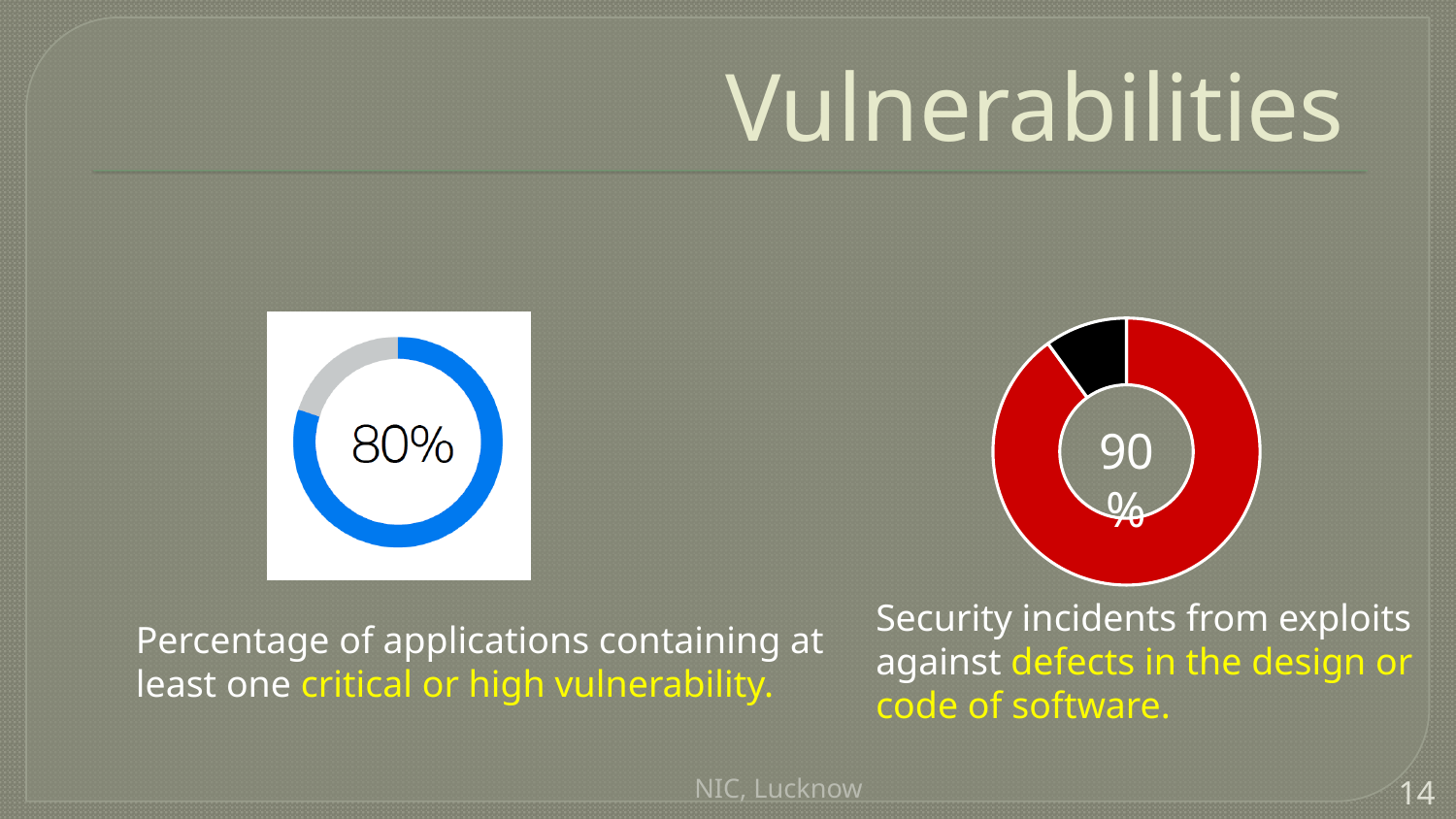
In the right chart, what percentage is printed in the centre of the donut? 90% In the left chart, what percentage is printed in the centre of the donut? 80% In the left chart, what share of the donut does the blue segment represent? 80% In the right chart, what share of the donut does the black segment represent? 10% In the right chart, what share of the donut does the red segment represent? 90% How many segments does the left donut chart have? 2 What kind of chart is the left chart on the slide? Donut chart What colour is the larger segment of the right donut chart? Red What is the difference between the percentage shown in the right chart and the percentage shown in the left chart? 10% Which chart shows the larger highlighted percentage, the left chart (80%) or the right chart (90%)? The right chart What kind of chart is the right chart on the slide? Donut chart